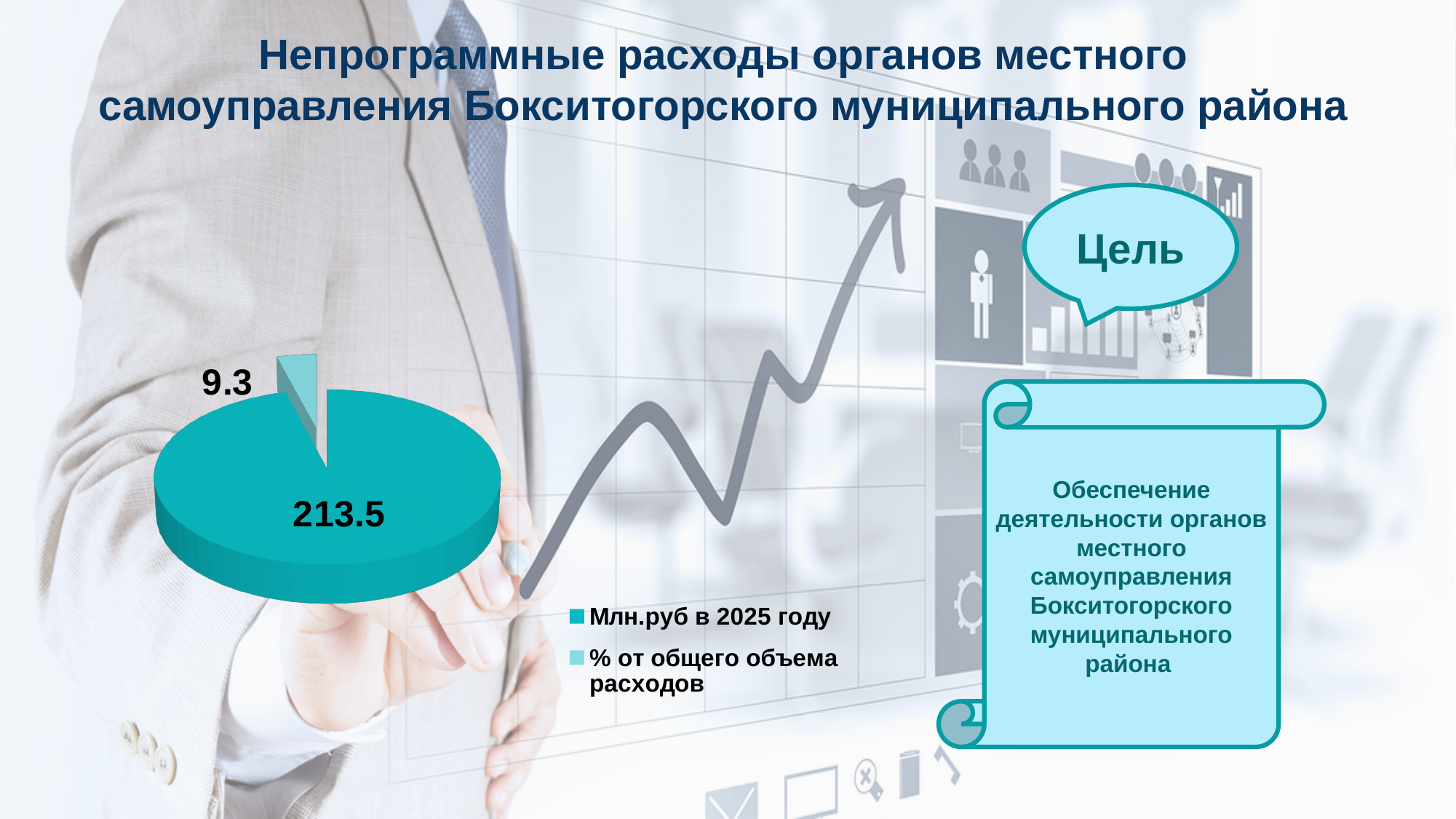
Which slice of the pie chart has the largest value? Млн.руб в 2025 году How many entries does the legend of the pie chart list? 2 What is the title of the slide containing the pie chart? Непрограммные расходы органов местного самоуправления Бокситогорского муниципального района What type of chart is shown on the slide? pie chart Which is larger: the value for "Млн.руб в 2025 году" or the value for "% от общего объема расходов"? Млн.руб в 2025 году How many slices does the pie chart have? 2 What is the difference between the two values shown on the pie chart (213.5 and 9.3)? 204.2 What value is shown for the slice labelled "% от общего объема расходов"? 9.3 Which legend entry is shown in the lighter teal colour? % от общего объема расходов Which slice of the pie chart has the smallest value? % от общего объема расходов What value is shown for the slice labelled "Млн.руб в 2025 году"? 213.5